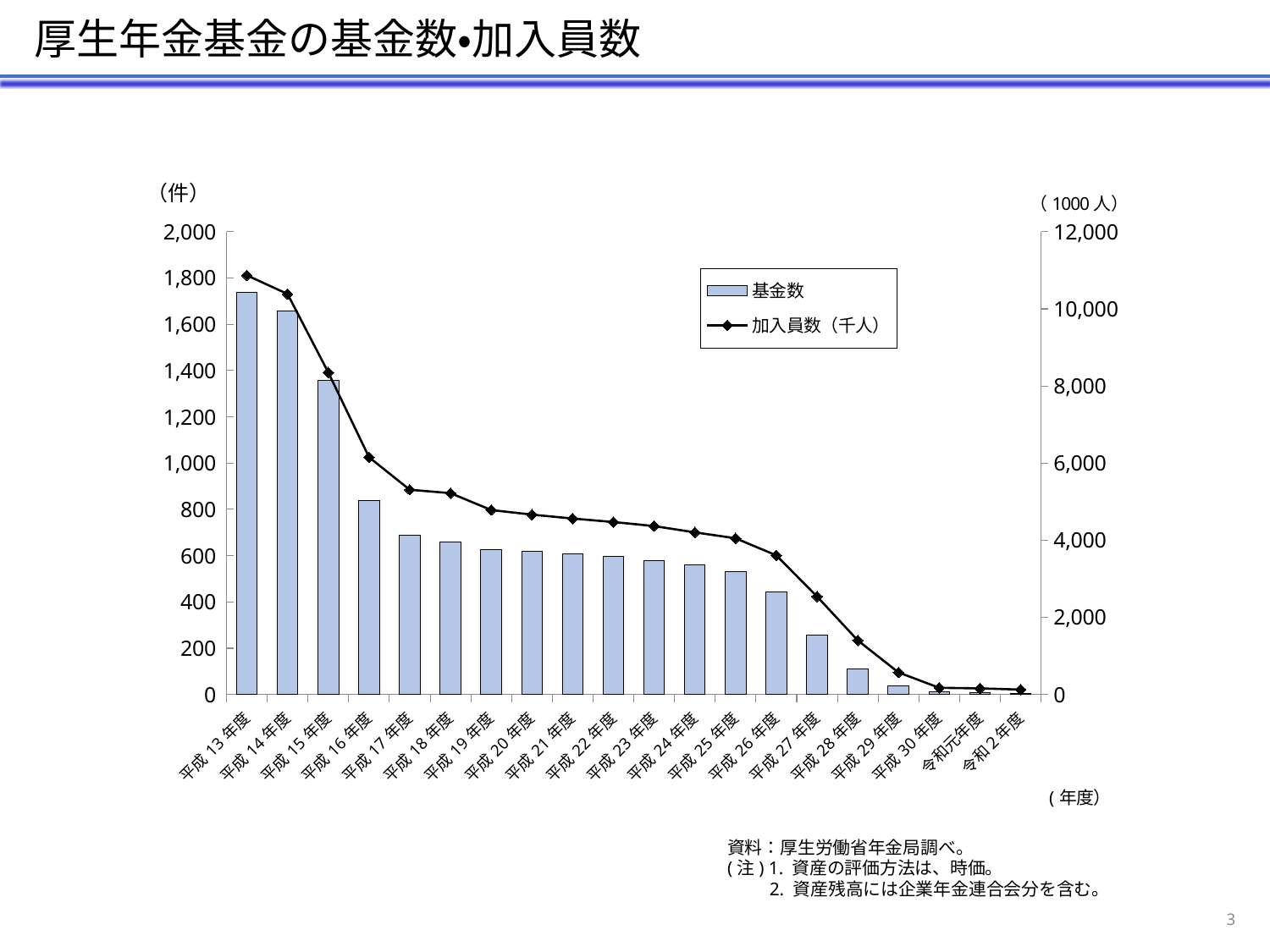
Which fiscal year has the highest 基金数 (number of funds)? 平成13年度 Is the 基金数 for 平成13年度 greater or less than 1,600? greater Is the 基金数 for 平成28年度 greater or less than 200? less Which is larger, the 基金数 for 平成17年度 or for 平成27年度? 平成17年度 Do the 基金数 values rise or fall from 平成13年度 to 令和2年度? fall Which fiscal year has the highest 加入員数 (number of members)? 平成13年度 Is the 加入員数 for 平成15年度 greater or less than 8,000 (thousand people)? greater How many fiscal years (categories) are plotted along the x axis? 20 How many series does the legend list? 2 What kind of chart is shown on the slide? A combined bar and line chart